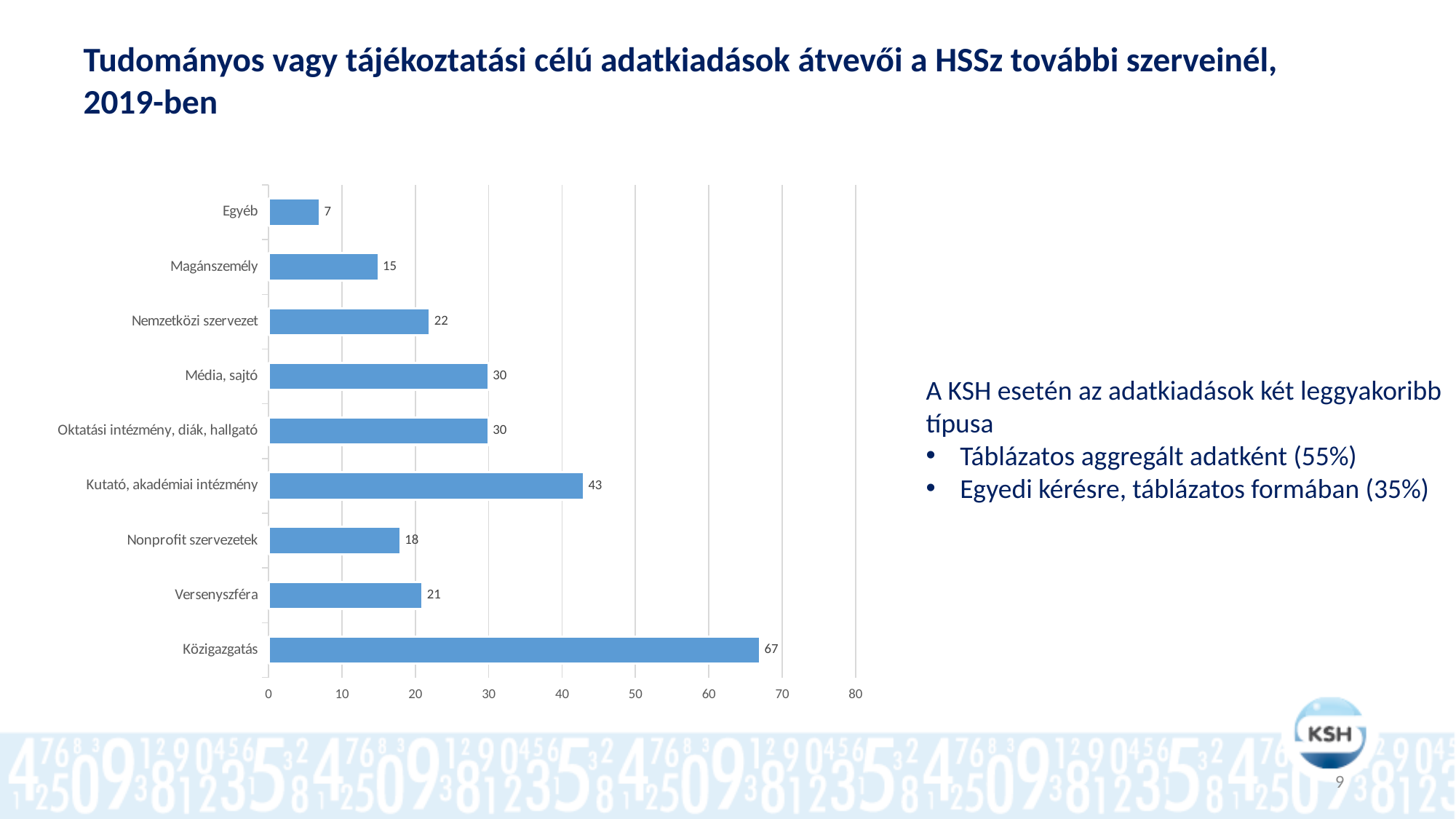
Which category has the lowest value? Egyéb Is the value for Média, sajtó greater or less than 20? greater What is the value for Közigazgatás? 67 What is the value for Magánszemély? 15 What kind of chart is shown on the slide? Bar chart Which is larger, the value for Nemzetközi szervezet or the value for Versenyszféra? Nemzetközi szervezet How many categories are shown in the chart? 9 What is the highest value shown on the horizontal axis? 80 Which category has the highest value? Közigazgatás What is the difference between the values for Nonprofit szervezetek and Egyéb? 11 What is the value for Kutató, akadémiai intézmény? 43 What is the difference between the values for Közigazgatás and Kutató, akadémiai intézmény? 24